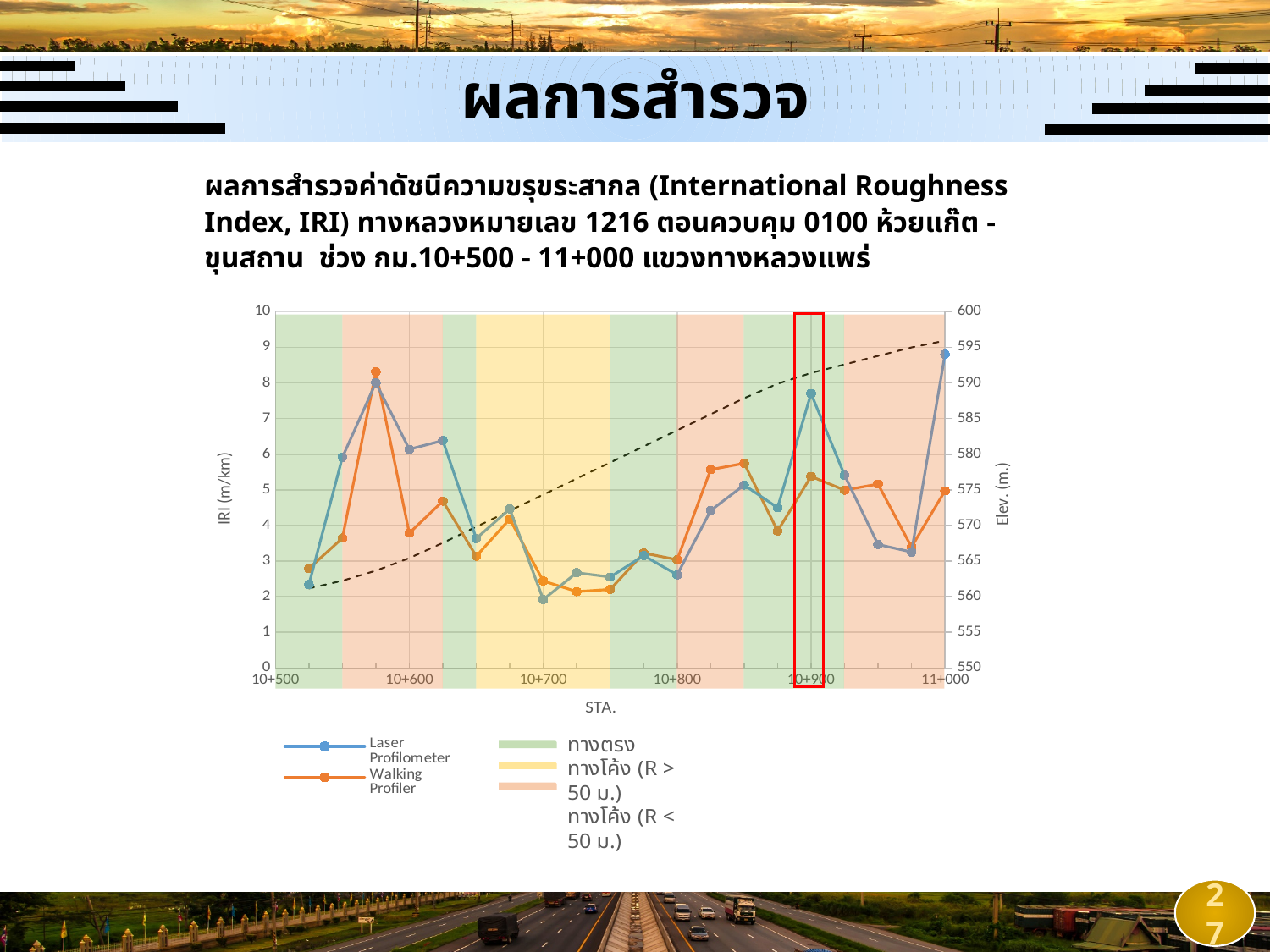
What is the label of the left vertical axis? IRI (m/km) Does the dashed elevation line rise or fall from 10+500 to 11+000? rise At 11+000, which series has the larger value, Laser Profilometer or Walking Profiler? Laser Profilometer At 10+900, which series has the larger value, Laser Profilometer or Walking Profiler? Laser Profilometer Is the Walking Profiler value at 10+600 greater or less than 4? less Is the Walking Profiler value at 11+000 greater or less than 6? less Is the Laser Profilometer value at 11+000 greater or less than 8? greater How many data series does the legend list for the plotted lines? 2 What kind of chart is shown on the slide? line chart At which station does the Walking Profiler series reach its highest value? 10+575 What is the label of the horizontal axis? STA.